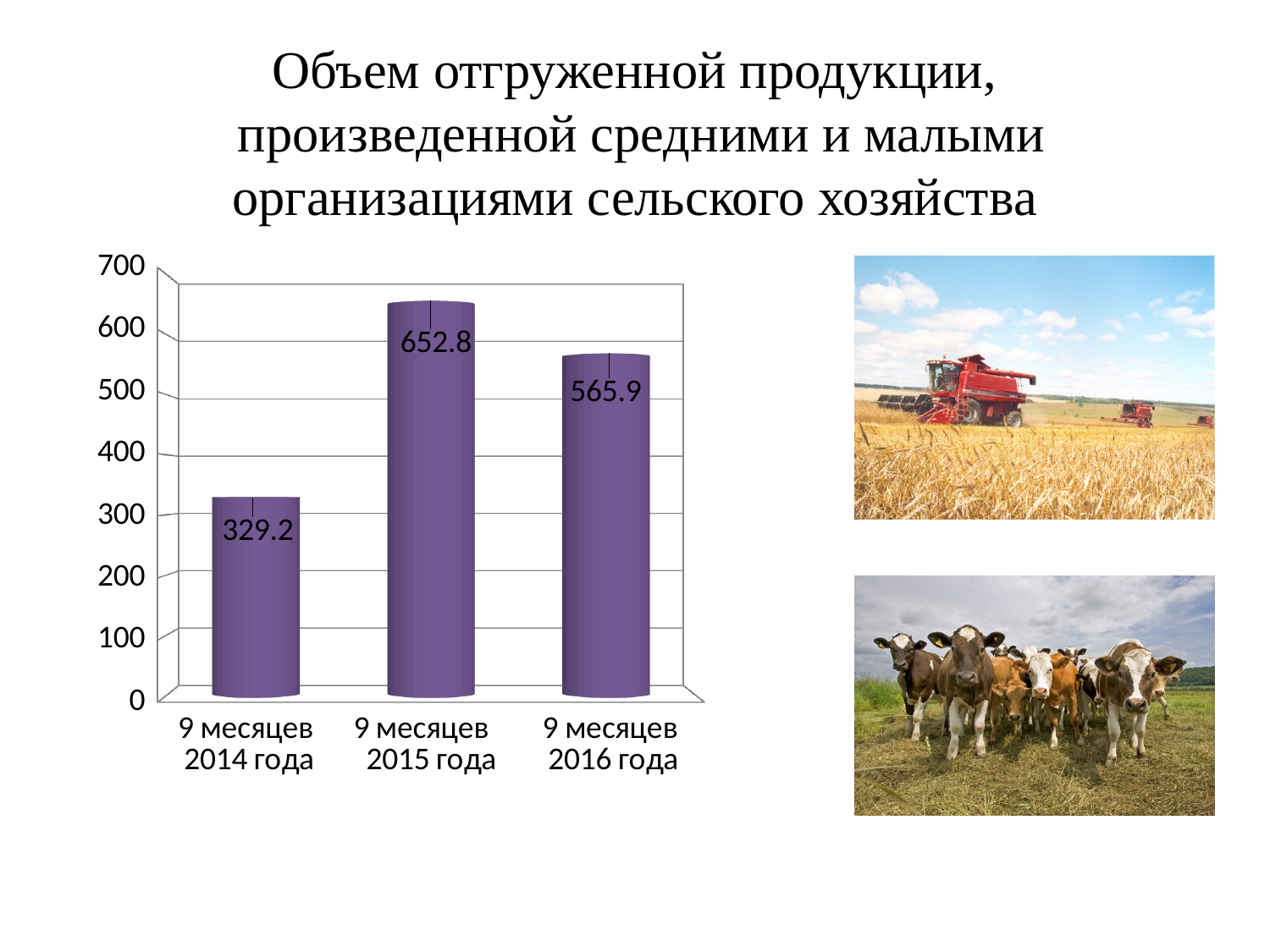
What is the value for 9 месяцев 2016 года? 565.9 Is the value for 9 месяцев 2016 года greater or less than 500? greater Which is larger, the value for 9 месяцев 2016 года or 9 месяцев 2014 года? 9 месяцев 2016 года What is the title of the slide? Объем отгруженной продукции, произведенной средними и малыми организациями сельского хозяйства What is the difference between the values for 9 месяцев 2015 года and 9 месяцев 2014 года? 323.6 Which period has the lowest value? 9 месяцев 2014 года Which period has the highest value? 9 месяцев 2015 года How many categories are shown on the chart? 3 What is the value for 9 месяцев 2014 года? 329.2 What is the difference between the values for 9 месяцев 2015 года and 9 месяцев 2016 года? 86.9 What kind of chart is shown on the slide? bar chart What is the value for 9 месяцев 2015 года? 652.8